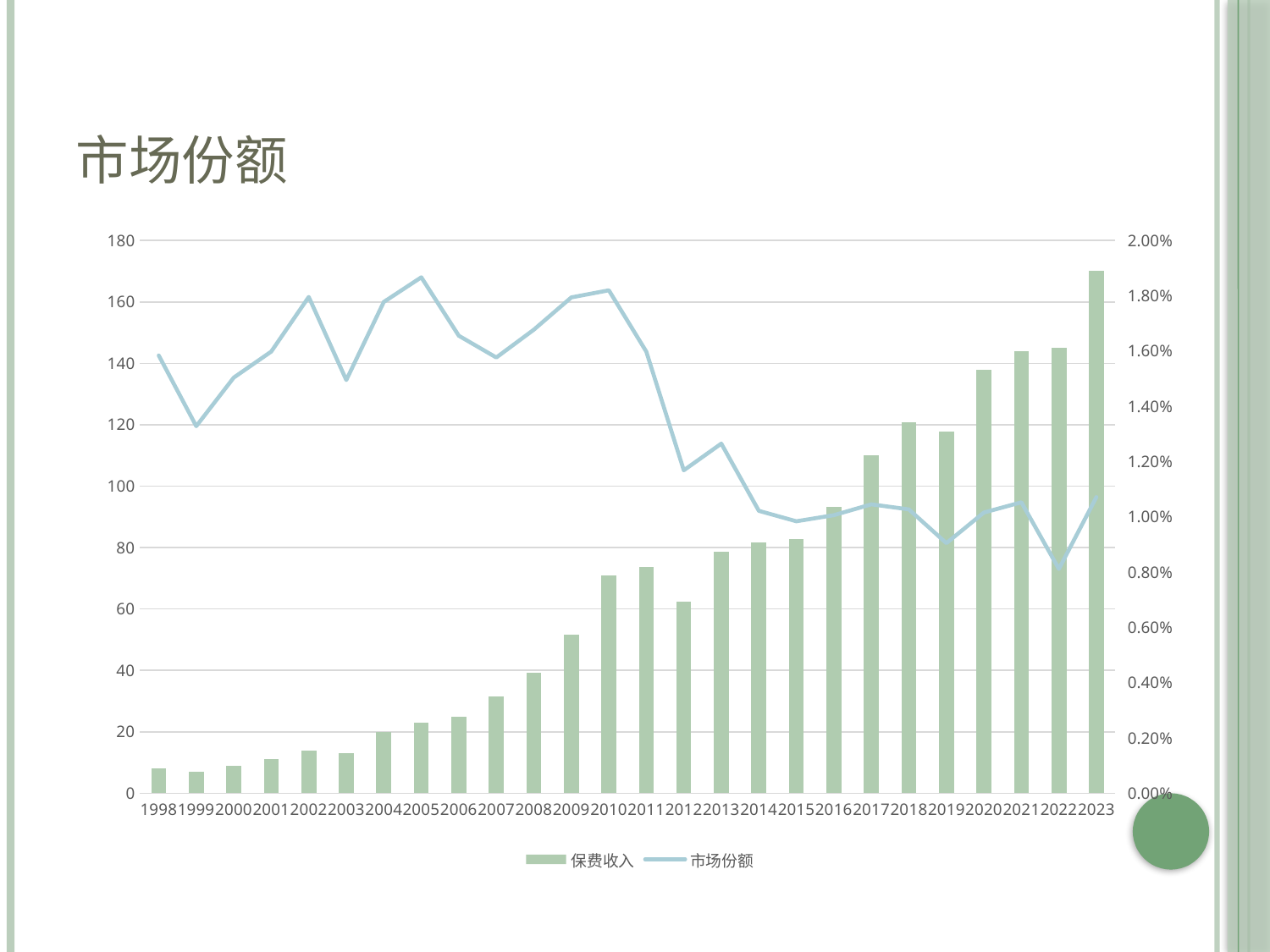
Which year has the lowest point on the 市场份额 line? 2022 What are the two series named in the legend? 保费收入 and 市场份额 Is the 保费收入 value for 2009 greater or less than 40? greater What kind of chart is shown on the slide? A combined bar and line chart Which year has the larger 保费收入 bar, 2011 or 2012? 2011 How many years are shown on the x axis? 26 Which year has the lowest 保费收入 bar? 1999 Which year has the highest 保费收入 bar? 2023 Do the 保费收入 bars generally rise or fall from 1998 to 2023? rise Is the 保费收入 value for 2023 greater or less than 160? greater Is the 市场份额 value for 2022 greater or less than 1.00%? less How many series does the legend list? 2